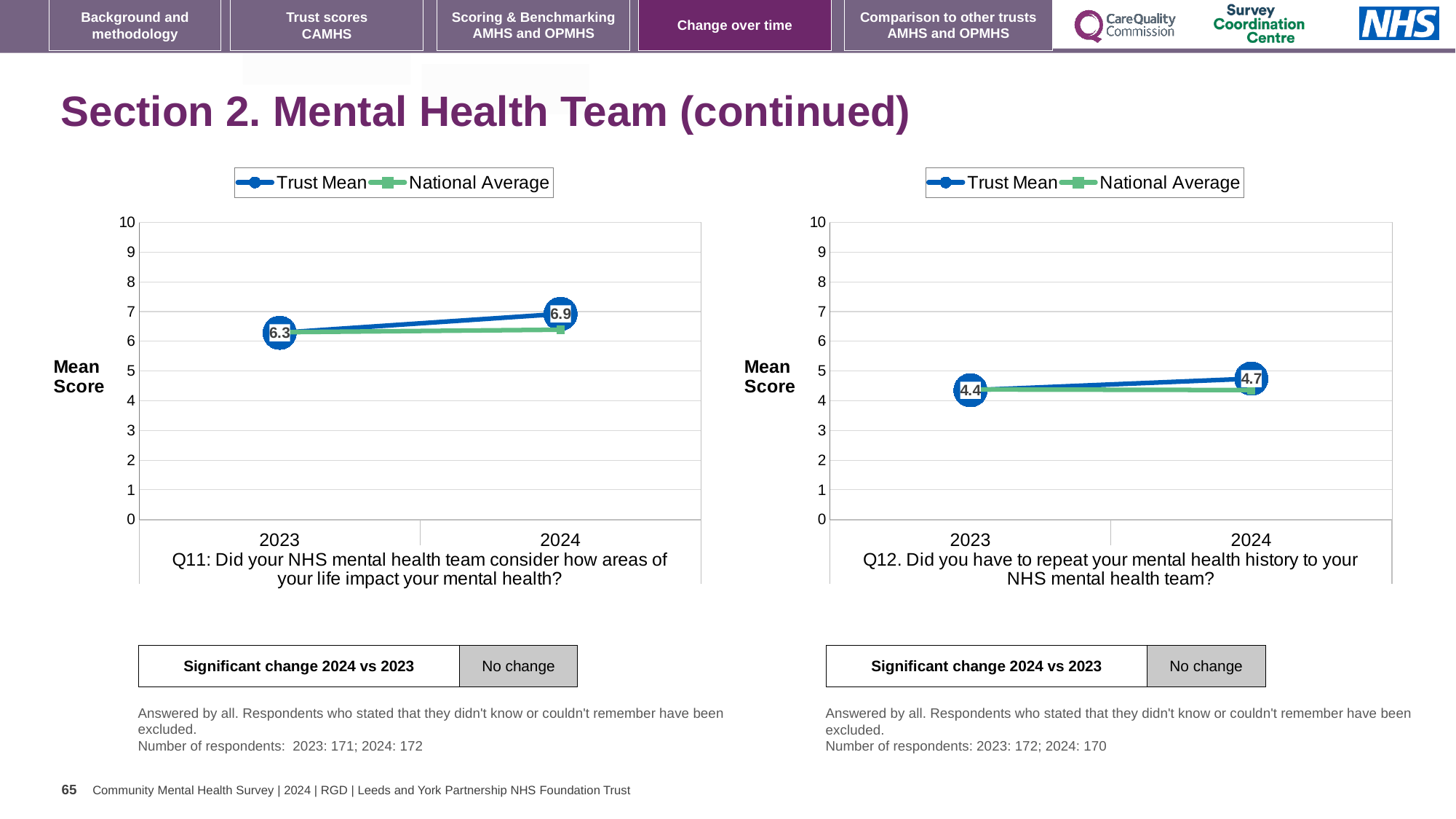
In the Q12 chart on the right, by how much did the Trust Mean change from 2023 to 2024? 0.3 How many series does the legend of the Q11 chart on the left list? 2 In the Q11 chart on the left, by how much did the Trust Mean change from 2023 to 2024? 0.6 In the Q11 chart on the left, what is the Trust Mean score for 2023? 6.3 What type of chart is the Q12 chart on the right? line chart In the Q11 chart on the left, does the Trust Mean rise or fall from 2023 to 2024? rise In the Q11 chart on the left, which series has the higher value in 2024, Trust Mean or National Average? Trust Mean In the Q12 chart on the right, what is the Trust Mean score for 2023? 4.4 In the Q12 chart on the right, what is the Trust Mean score for 2024? 4.7 In the Q12 chart on the right, is the National Average value for 2024 greater or less than 5? less In the Q11 chart on the left, what is the Trust Mean score for 2024? 6.9 How many years are shown on the x axis of the Q12 chart on the right? 2